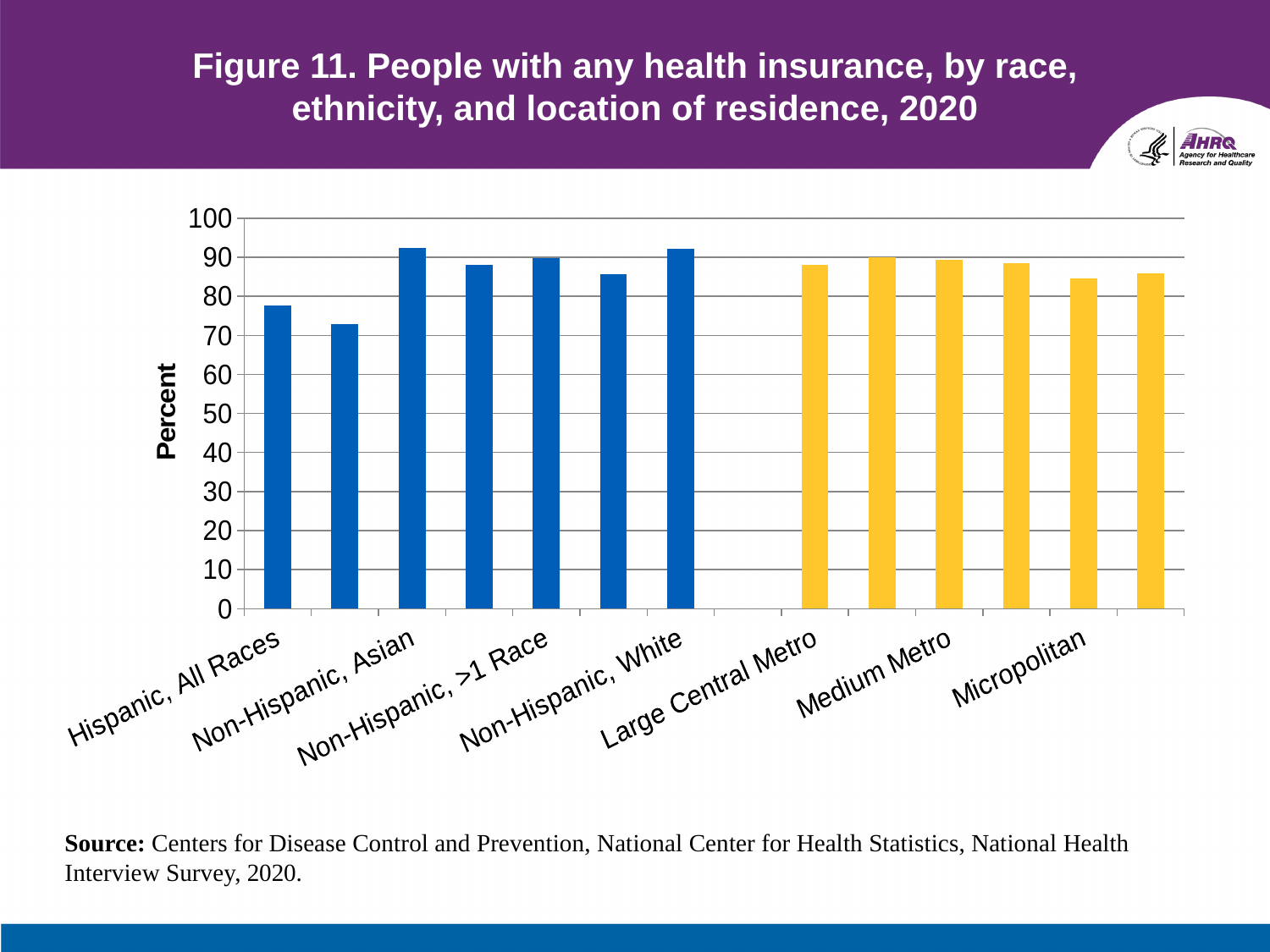
What is the label on the vertical axis of the chart? Percent Is the value for Non-Hispanic, Asian greater or less than 90? greater Is the value for Hispanic, All Races greater or less than 80? less Which is larger, the value for Hispanic, All Races or the value for Micropolitan? Micropolitan Is the value for Non-Hispanic, White greater or less than 90? greater What kind of chart is shown on the slide? bar chart How many bars are plotted in the chart? 13 Which is larger, the value for Non-Hispanic, Asian or the value for Micropolitan? Non-Hispanic, Asian What colour are the bars for the location of residence categories (Large Central Metro, Medium Metro, Micropolitan)? yellow Which is larger, the value for Hispanic, All Races or the value for Non-Hispanic, White? Non-Hispanic, White